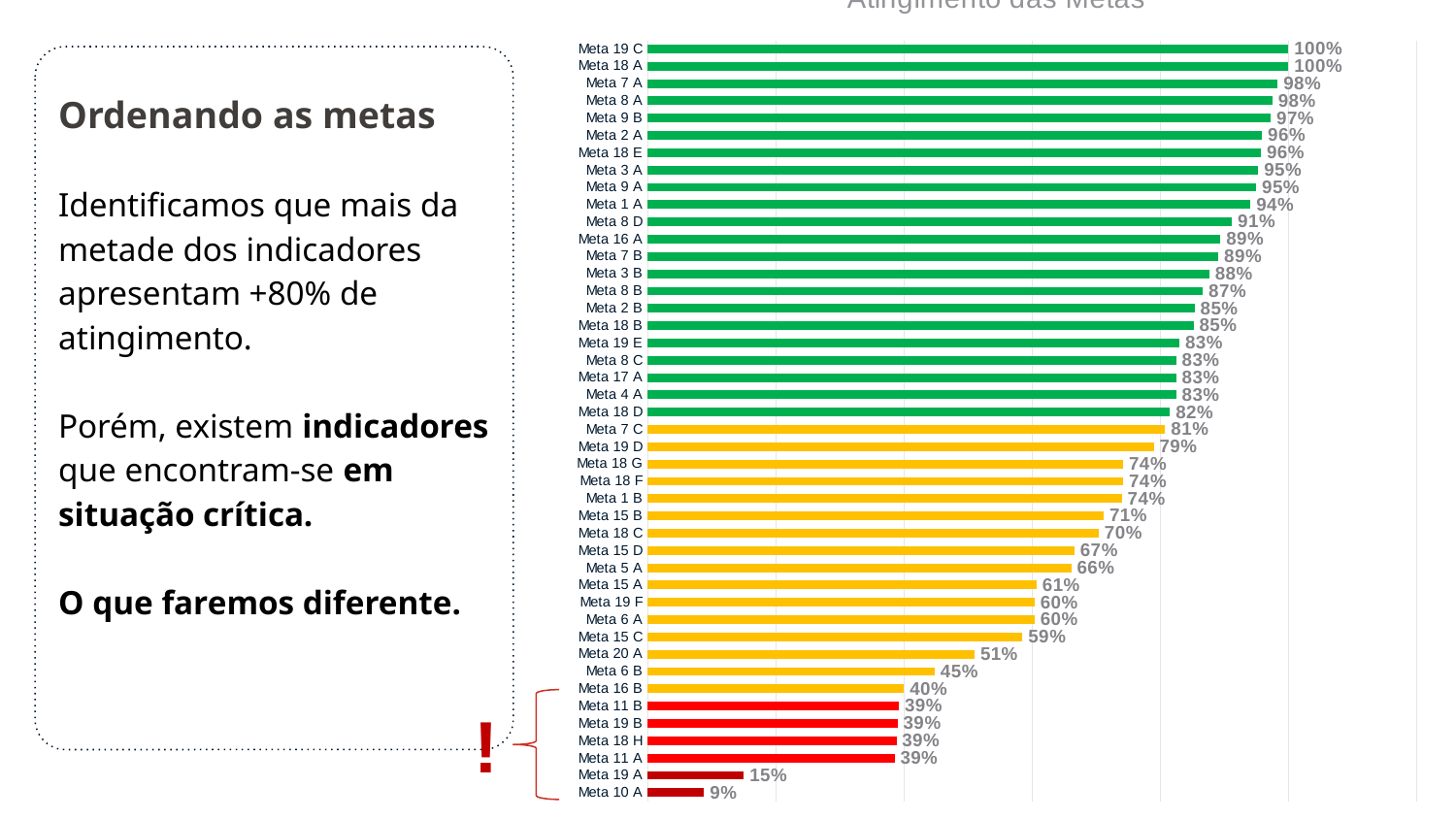
Do the values rise or fall going from the top bar to the bottom bar? Fall How many categories are plotted in the chart? 44 How many bars are coloured red? 6 Which category has the lowest value? Meta 10 A What is the difference between the values for Meta 1 A and Meta 6 B? 49% Which is larger, the value for Meta 20 A or the value for Meta 5 A? Meta 5 A What is the value for Meta 9 B? 97% Which is larger, the value for Meta 8 D or the value for Meta 19 D? Meta 8 D What is the difference between the values for Meta 16 B and Meta 10 A? 31% What kind of chart is shown on the slide? Bar chart What is the value for Meta 19 A? 15% What is the value for Meta 15 D? 67%